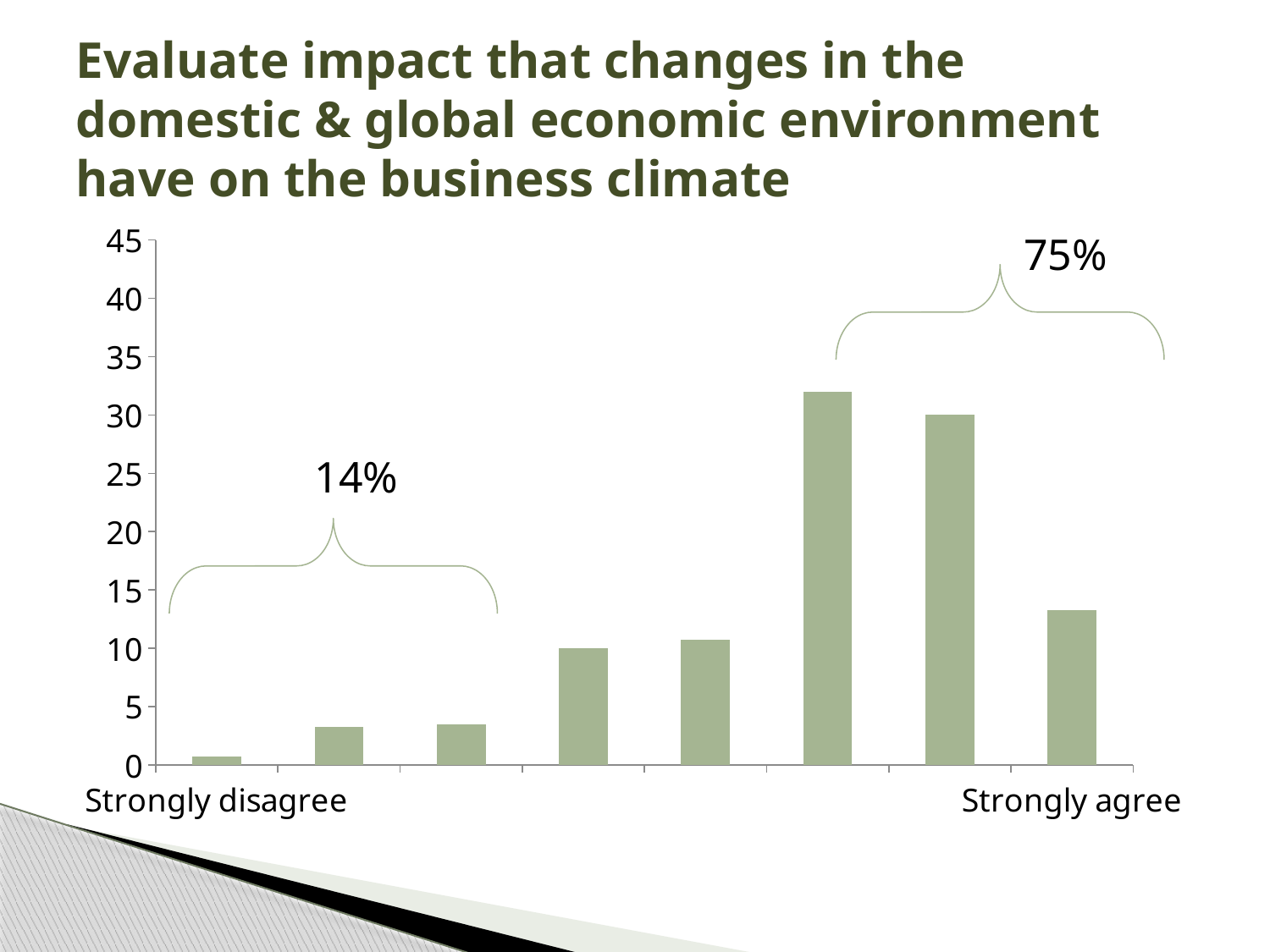
What kind of chart is shown on the slide? Bar chart What percentage is annotated above the three bars nearest the 'Strongly disagree' end? 14% What label appears at the right end of the x axis? Strongly agree Is the value of the sixth bar from the left greater or less than 30? greater Is the value of the leftmost bar greater or less than 5? less What label appears at the left end of the x axis? Strongly disagree Which bar is the shortest in the chart? The leftmost bar (Strongly disagree end) What percentage is annotated above the three bars nearest the 'Strongly agree' end? 75% Which is taller, the sixth bar from the left or the rightmost bar? The sixth bar from the left Is the value of the rightmost bar greater or less than 10? greater How many bars are plotted in the chart? 8